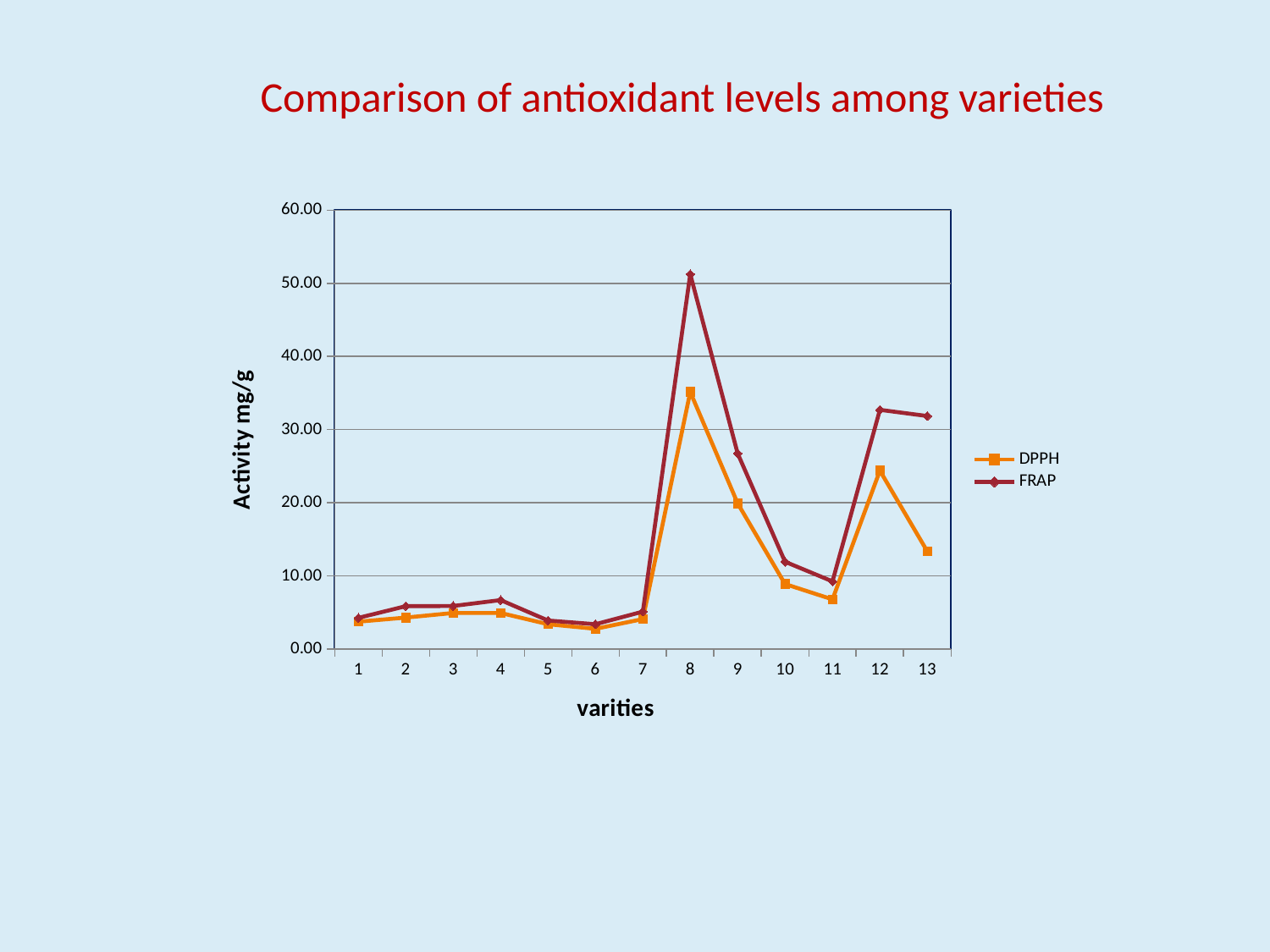
At variety 8, which series has the larger value, DPPH or FRAP? FRAP What kind of chart is shown on the slide? line chart How many series does the legend list? 2 Is the FRAP value for variety 8 greater or less than 40.00? greater What is the label on the y axis? Activity mg/g Do the FRAP values rise or fall from variety 8 to variety 11? fall How many varieties are plotted along the x axis? 13 Is the DPPH value for variety 11 greater or less than 10.00? less Which variety has the lowest DPPH value? 6 Which variety has the highest DPPH value? 8 Is the DPPH value for variety 12 greater or less than 30.00? less Which variety has the highest FRAP value? 8